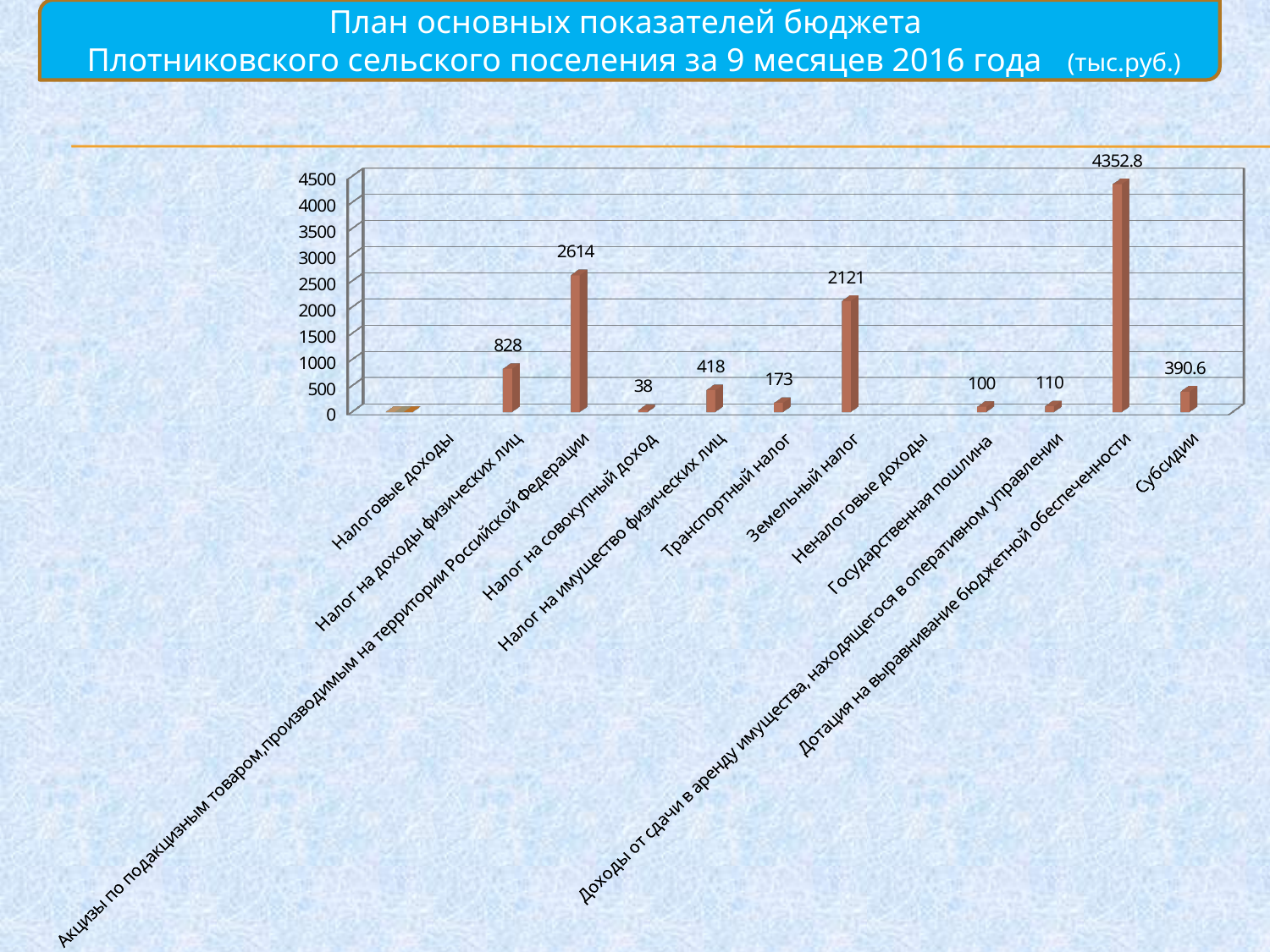
What is the value for Дотация на выравнивание бюджетной обеспеченности? 4352.8 What is the value for Субсидии? 390.6 What is the value for Налог на доходы физических лиц? 828 What is the difference between the values for Акцизы по подакцизным товарам, производимым на территории Российской Федерации and Земельный налог? 493 Which category has the highest value? Дотация на выравнивание бюджетной обеспеченности Is the value for Налог на доходы физических лиц greater or less than 1000? less What is the value for Земельный налог? 2121 Which is larger, the value for Налог на имущество физических лиц or the value for Транспортный налог? Налог на имущество физических лиц What kind of chart is shown on the slide? bar chart How many categories are shown on the x axis? 12 What unit is stated in the chart title? тыс.руб. What is the value for Налог на совокупный доход? 38